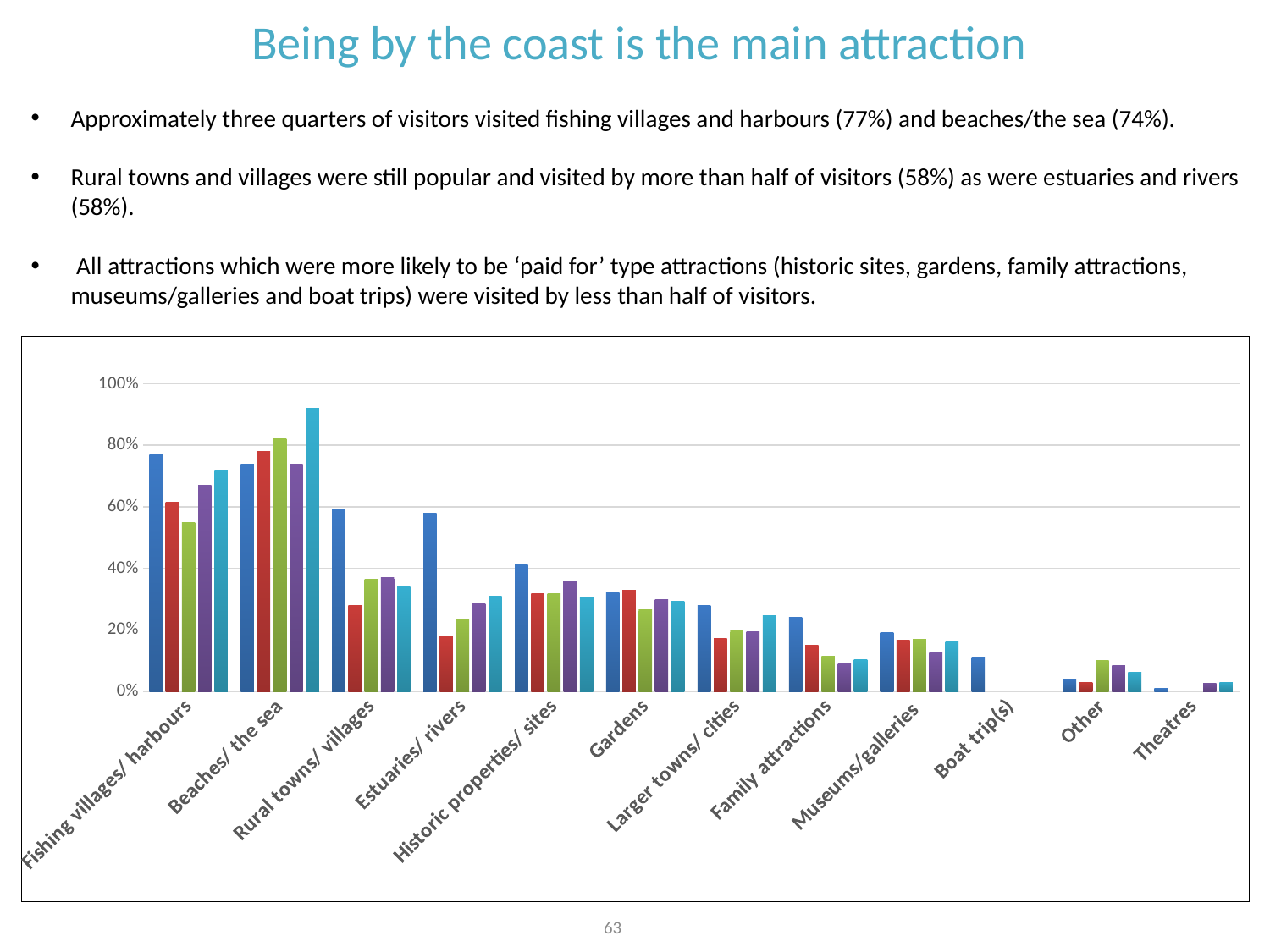
Is the value of the blue bar for Rural towns/ villages greater or less than 40%? greater Do the blue bars generally rise or fall moving from left to right along the x axis? fall Is the value of the last (teal) bar for Beaches/ the sea greater or less than 80%? greater Is the value of the red bar for Estuaries/ rivers greater or less than 40%? less What is the highest value shown on the chart's vertical axis? 100% Which has the larger blue bar: Family attractions or Museums/galleries? Family attractions Which has the larger blue bar: Historic properties/ sites or Gardens? Historic properties/ sites Which category contains the tallest bar in the chart? Beaches/ the sea How many categories are shown along the x axis of the chart? 12 What kind of chart is shown on the slide? bar chart